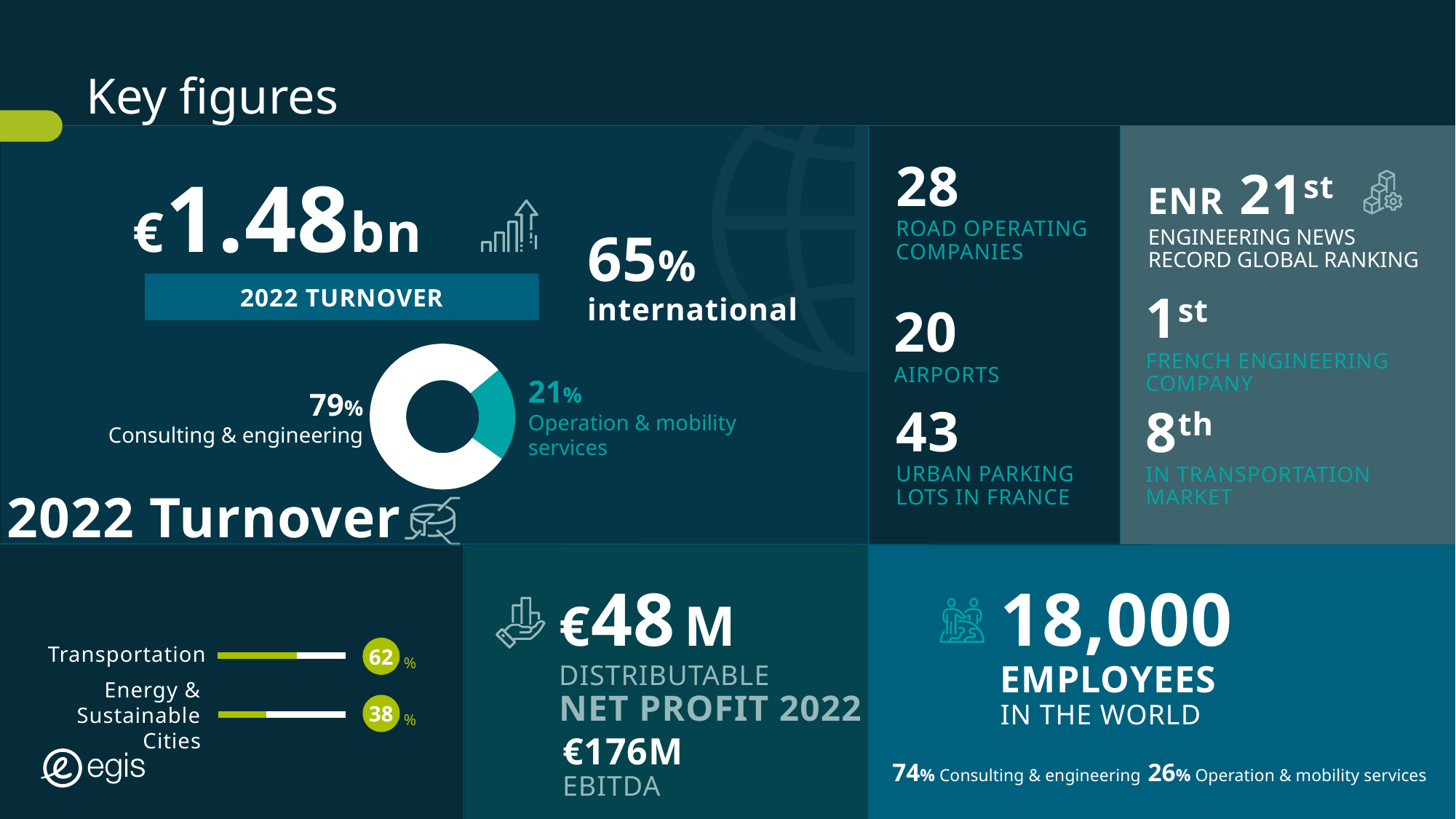
In the 2022 Turnover donut chart, what share is Operation & mobility services? 21% In the 2022 Turnover donut chart, which segment is the largest? Consulting & engineering In the 2022 Turnover donut chart, what is the difference in percentage points between Consulting & engineering and Operation & mobility services? 58 In the bar chart at the bottom left, what is the difference in percentage points between Transportation and Energy & Sustainable Cities? 24 In the 2022 Turnover donut chart, which segment is the smallest? Operation & mobility services In the bar chart at the bottom left, what is the value for Energy & Sustainable Cities? 38% How many segments does the 2022 Turnover donut chart have? 2 What kind of chart is used to show the 2022 Turnover split between Consulting & engineering and Operation & mobility services? Donut chart In the bar chart at the bottom left, which category has the higher value, Transportation or Energy & Sustainable Cities? Transportation What kind of chart is used at the bottom left to show Transportation and Energy & Sustainable Cities? Bar chart In the 2022 Turnover donut chart, what share is Consulting & engineering? 79% In the bar chart at the bottom left, what is the value for Transportation? 62%